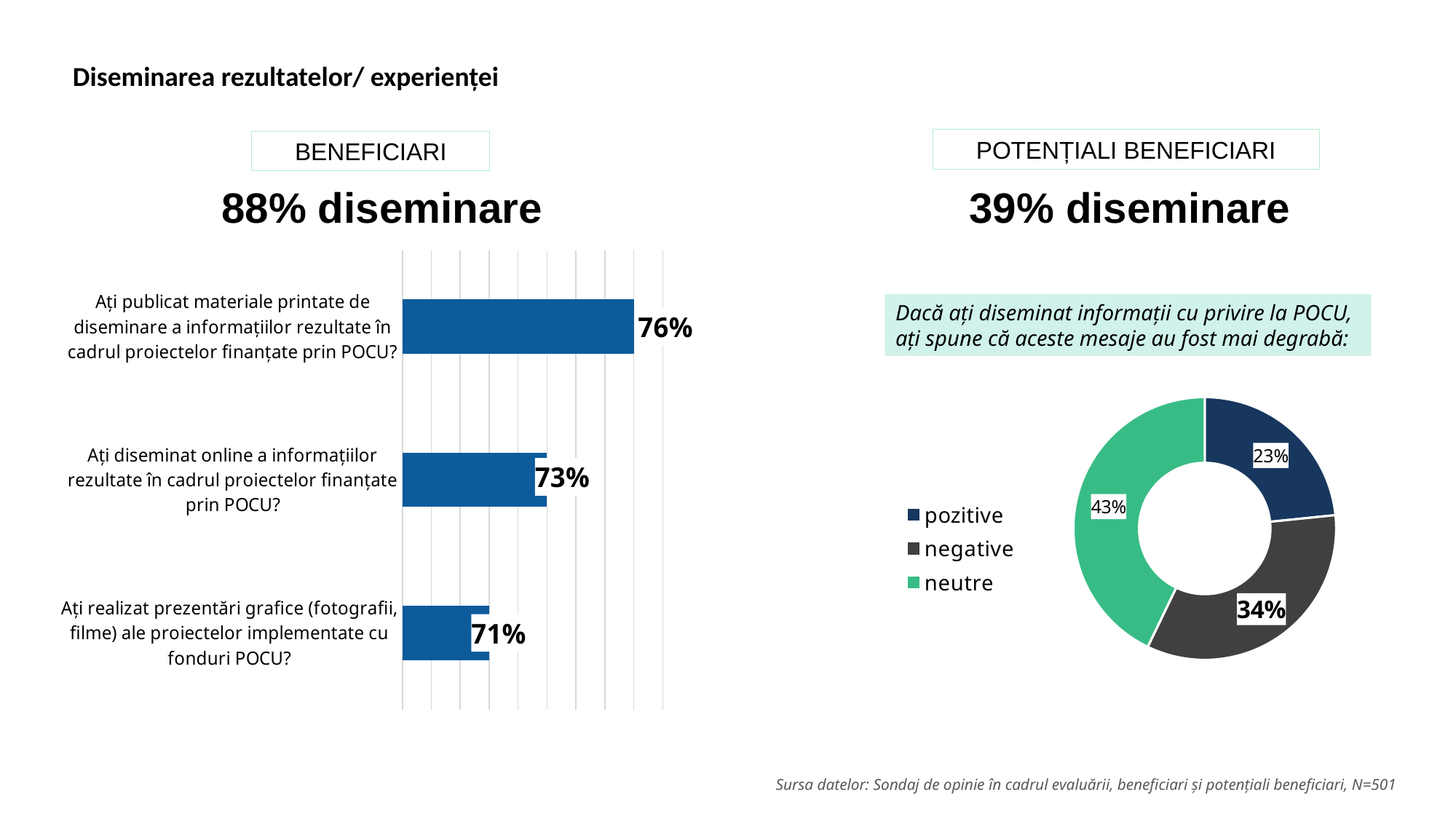
In the bar chart on the left, which category has the highest value? Ați publicat materiale printate de diseminare a informațiilor rezultate în cadrul proiectelor finanțate prin POCU? In the doughnut chart on the right, which slice is the largest? neutre In the bar chart on the left, how many categories are shown? 3 In the bar chart on the left, which category has the lowest value? Ați realizat prezentări grafice (fotografii, filme) ale proiectelor implementate cu fonduri POCU? In the bar chart on the left, what is the difference between the value for publishing printed materials and the value for making graphic presentations? 5% In the doughnut chart on the right, what share is 'neutre'? 43% In the doughnut chart on the right, what share is 'pozitive'? 23% In the doughnut chart on the right, how many entries does the legend list? 3 In the bar chart on the left, what is the value for 'Ați realizat prezentări grafice (fotografii, filme) ale proiectelor implementate cu fonduri POCU?' 71% In the bar chart on the left, what is the value for 'Ați diseminat online a informațiilor rezultate în cadrul proiectelor finanțate prin POCU?' 73% What kind of chart is shown on the left side of the slide? Bar chart In the bar chart on the left, what is the value for 'Ați publicat materiale printate de diseminare a informațiilor rezultate în cadrul proiectelor finanțate prin POCU?' 76%